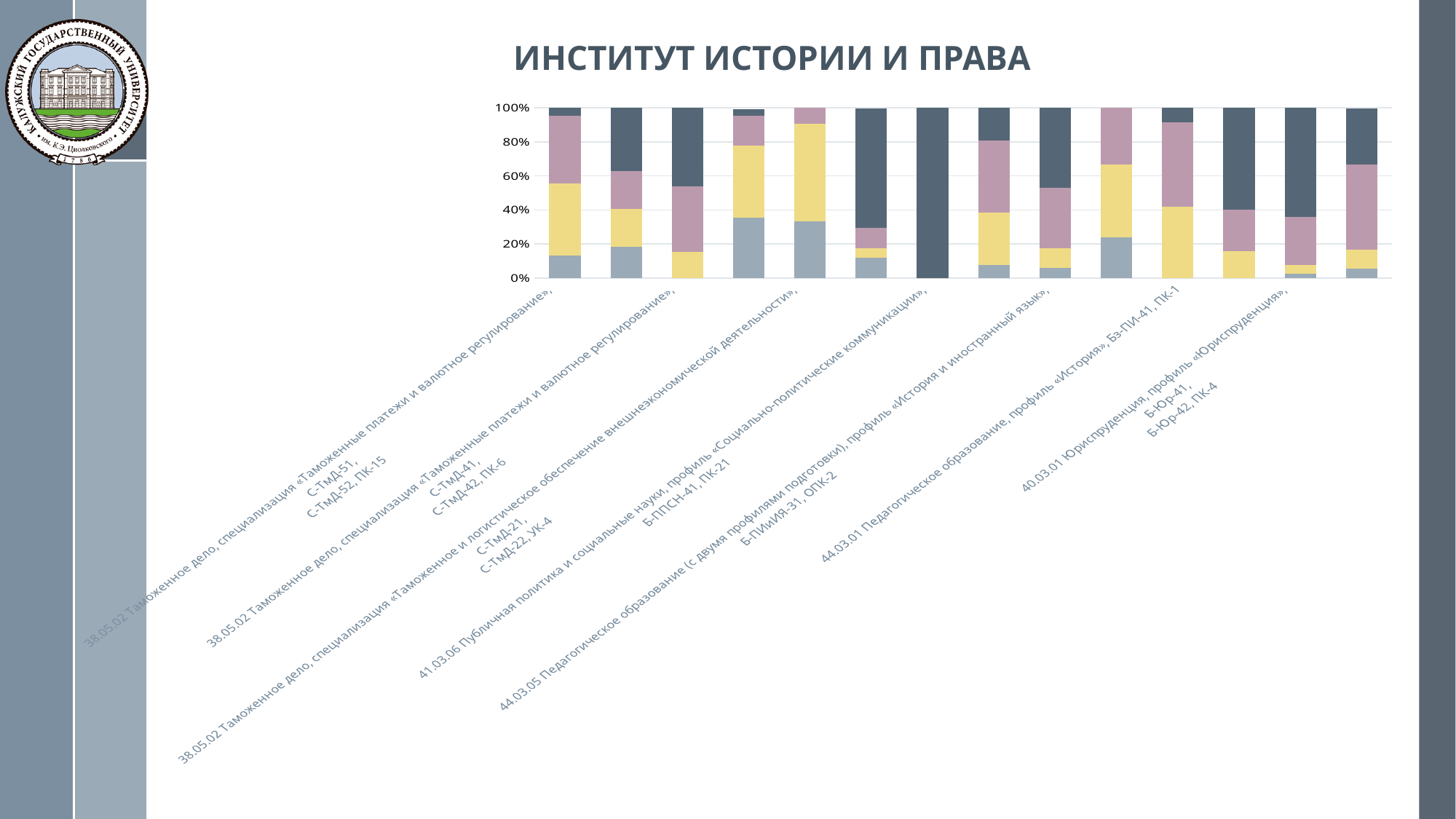
Is the bottom light grey segment of the first bar from the left greater or less than 20%? less Which has the larger bottom light grey segment, the first bar or the fourth bar from the left? The fourth bar Is the bottom light grey segment of the fourth bar from the left greater or less than 20%? greater What is the title of the slide above the chart? ИНСТИТУТ ИСТОРИИ И ПРАВА Is the dark top segment of the sixth bar from the left greater or less than 60%? greater Which bar has the largest dark top segment? The seventh bar from the left What kind of chart is shown on the slide? Stacked bar chart What is the highest value shown on the vertical axis? 100% How many bars are plotted in the chart? 14 How many differently coloured segment types are stacked in the bars? 4